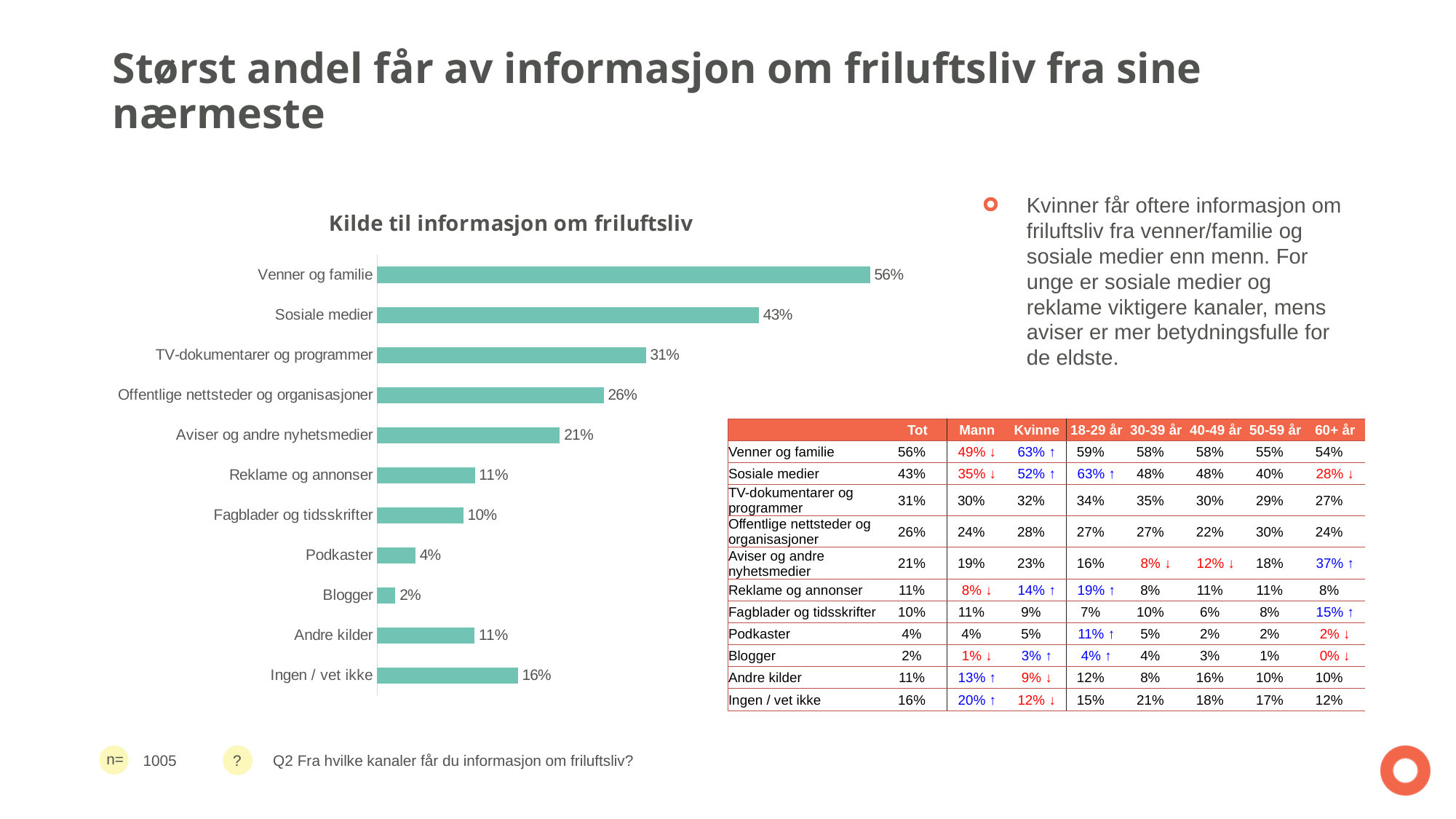
Which category has the lowest value in the chart? Blogger What kind of chart is shown on the slide? Bar chart What is the value for Sosiale medier in the chart? 43% What is the title of the chart? Kilde til informasjon om friluftsliv What is the value for Podkaster in the chart? 4% What is the value for Ingen / vet ikke in the chart? 16% What is the difference between the values for TV-dokumentarer og programmer and Offentlige nettsteder og organisasjoner? 5% Which is larger: the value for Aviser og andre nyhetsmedier or the value for Ingen / vet ikke? Aviser og andre nyhetsmedier Which category has the highest value in the chart? Venner og familie What is the value for Venner og familie in the chart? 56% How many categories are shown in the chart? 11 What is the difference between the values for Venner og familie and Sosiale medier? 13%